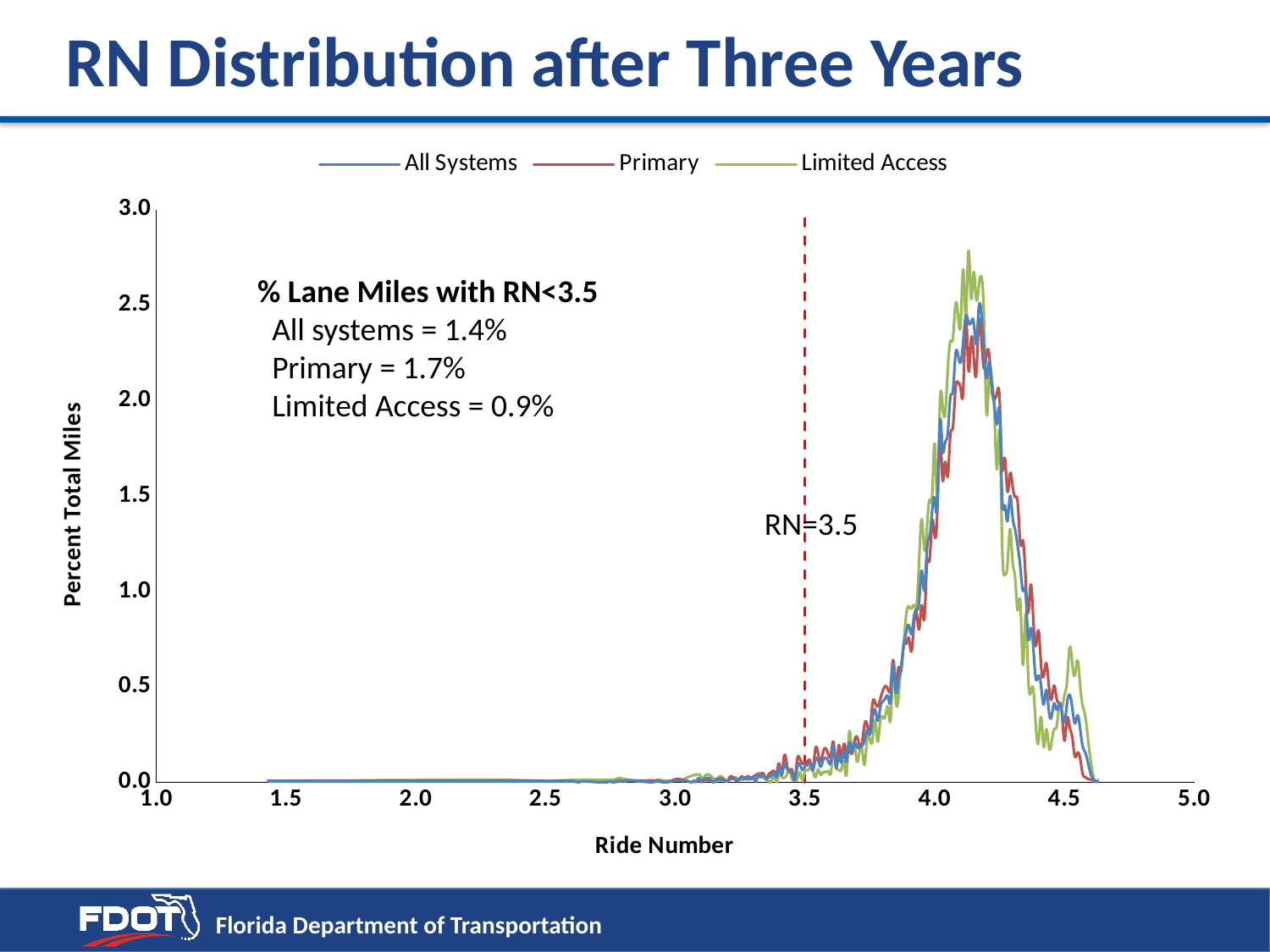
According to the annotation, what percent of lane miles have RN<3.5 for Primary? 1.7% What is the title of the chart's y axis? Percent Total Miles According to the annotation, what percent of lane miles have RN<3.5 for Limited Access? 0.9% How many series does the legend list? 3 What is the title of the chart's x axis? Ride Number Which system has the highest percent of lane miles with RN<3.5? Primary What is the difference between the Primary and Limited Access percentages of lane miles with RN<3.5? 0.8% Which system has the lowest percent of lane miles with RN<3.5? Limited Access What kind of chart is shown on the slide? Line chart Is the peak value of the Limited Access line greater or less than 2.5? greater According to the annotation, what percent of lane miles have RN<3.5 for All systems? 1.4% Which series reaches the highest peak on the chart? Limited Access